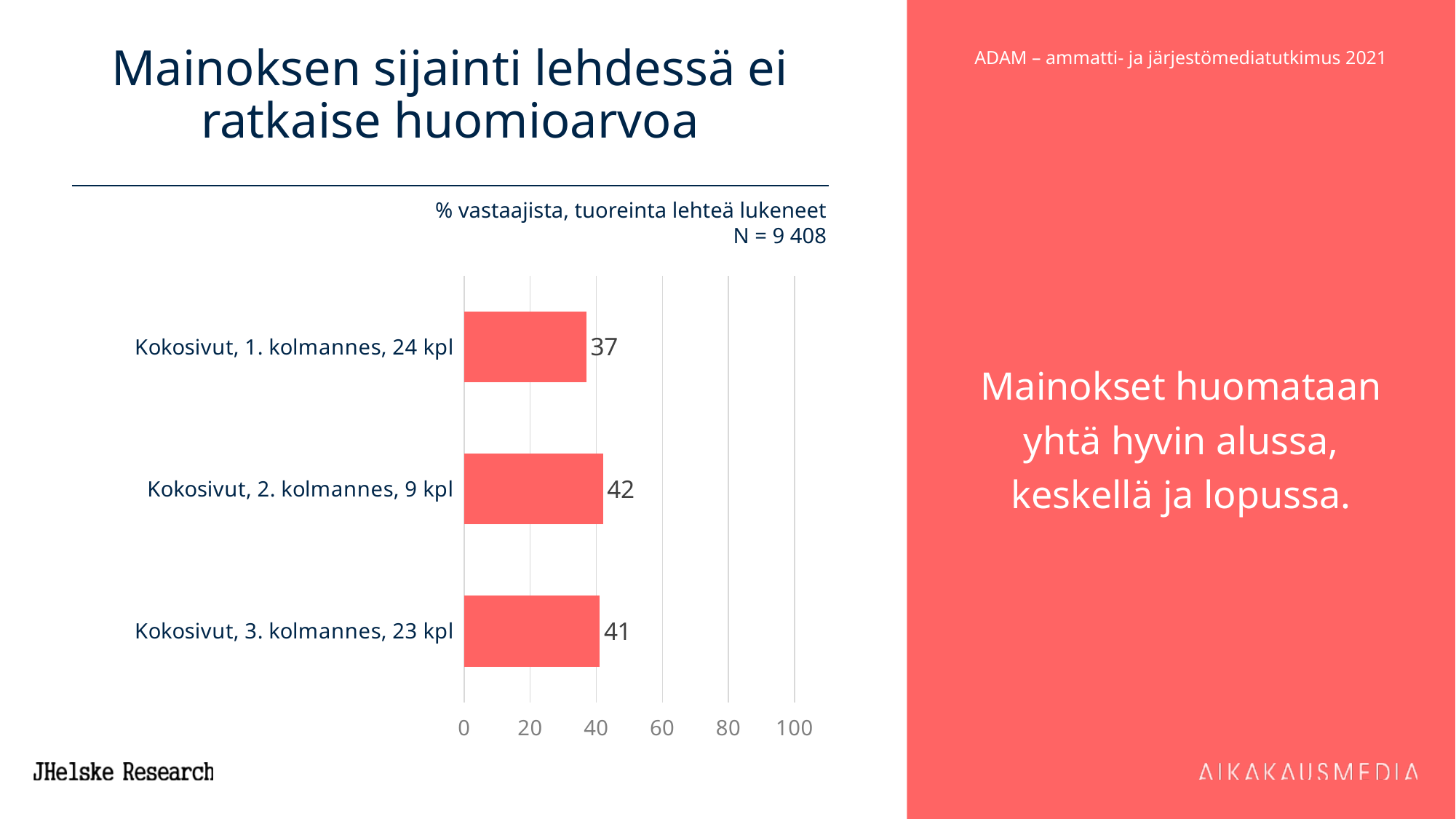
How many categories are shown in the chart? 3 What is the value for Kokosivut, 1. kolmannes, 24 kpl? 37 Which category has the highest value? Kokosivut, 2. kolmannes, 9 kpl What is the sample size (N) stated above the chart? N = 9 408 Is the value for Kokosivut, 1. kolmannes, 24 kpl greater or less than 40? less Which is larger, the value for Kokosivut, 1. kolmannes, 24 kpl or Kokosivut, 3. kolmannes, 23 kpl? Kokosivut, 3. kolmannes, 23 kpl What is the difference between the values for Kokosivut, 3. kolmannes, 23 kpl and Kokosivut, 1. kolmannes, 24 kpl? 4 What is the value for Kokosivut, 2. kolmannes, 9 kpl? 42 What is the value for Kokosivut, 3. kolmannes, 23 kpl? 41 What is the difference between the values for Kokosivut, 2. kolmannes, 9 kpl and Kokosivut, 1. kolmannes, 24 kpl? 5 Which category has the lowest value? Kokosivut, 1. kolmannes, 24 kpl What kind of chart is shown on the slide? bar chart